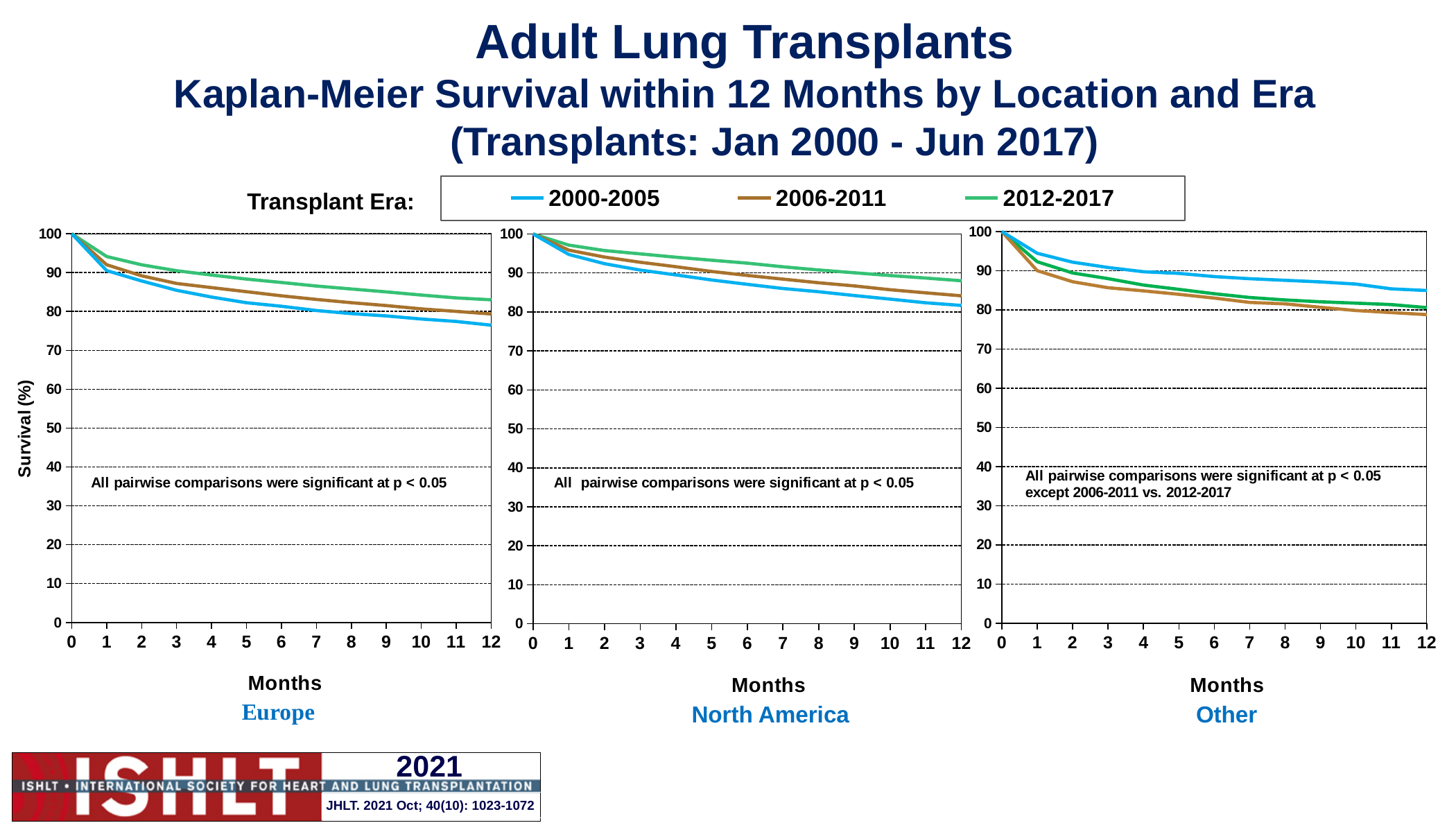
In the North America chart, which era has the lowest survival at 12 months? 2000-2005 What kind of chart is used for the Europe panel? line chart What is the label on the vertical axis of the charts? Survival (%) In the Europe chart, does survival rise or fall as months increase? fall In the Other chart, at 12 months, which is larger: survival for 2000-2005 or for 2006-2011? 2000-2005 In the Europe chart, is the 2000-2005 survival at 12 months greater or less than 80? less How many transplant eras does the legend list? 3 In the Other chart, which transplant era has the highest survival at 12 months? 2000-2005 In the North America chart, is the 2012-2017 survival at 12 months greater or less than 90? less In the Europe chart, is the 2012-2017 survival at 12 months greater or less than 80? greater In the North America chart, which transplant era has the highest survival at 12 months? 2012-2017 How many location panels (charts) are shown on the slide? 3